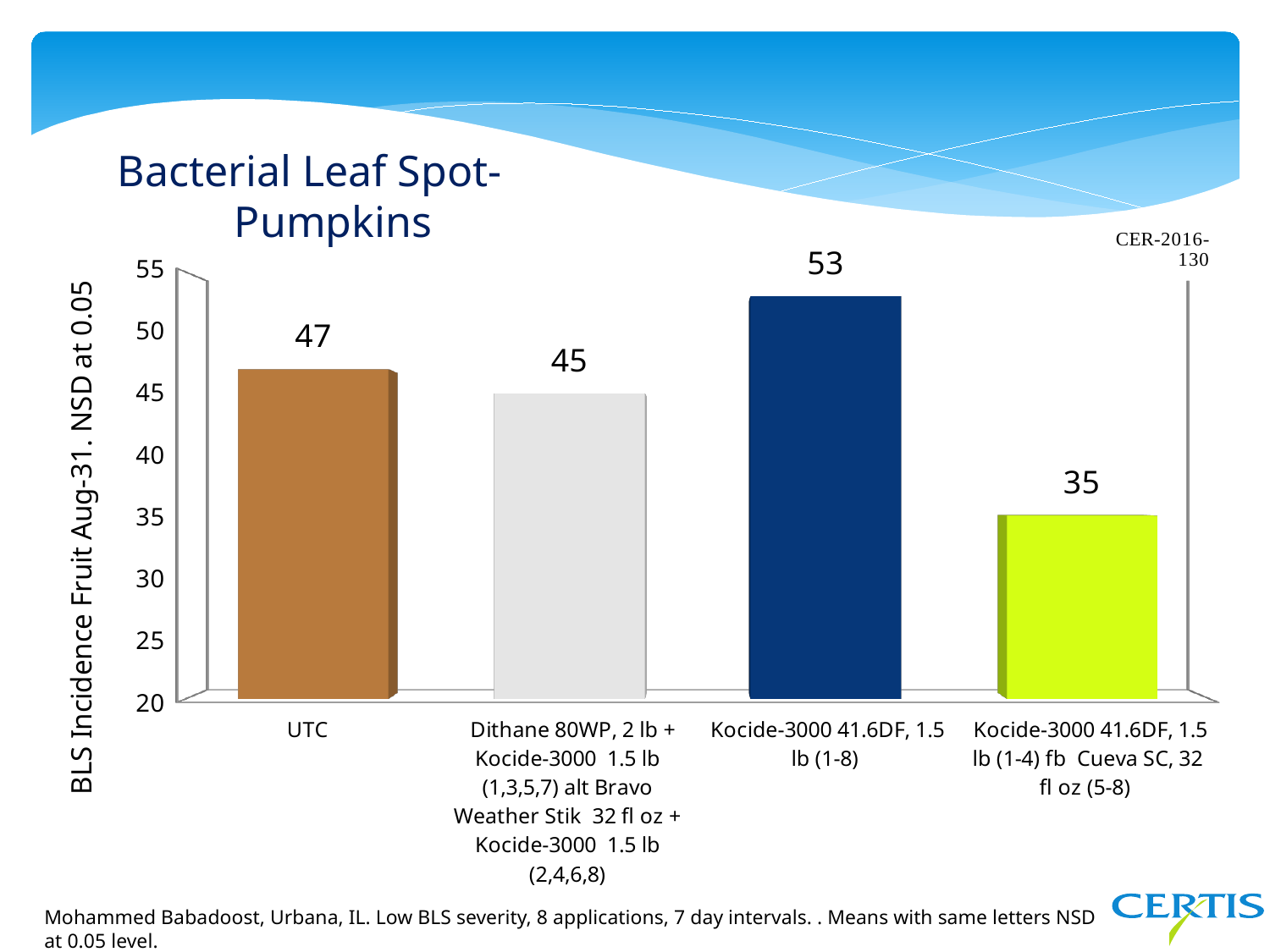
What is the value for the Kocide-3000 41.6DF, 1.5 lb (1-4) fb Cueva SC, 32 fl oz (5-8) treatment? 35 What is the label on the vertical axis of the chart? BLS Incidence Fruit Aug-31. NSD at 0.05 Which is larger, the value for UTC or the value for Kocide-3000 41.6DF, 1.5 lb (1-8)? Kocide-3000 41.6DF, 1.5 lb (1-8) Which treatment has the lowest BLS incidence? Kocide-3000 41.6DF, 1.5 lb (1-4) fb Cueva SC, 32 fl oz (5-8) What is the title of the slide? Bacterial Leaf Spot- Pumpkins What kind of chart is shown on the slide? Bar chart What is the difference between the UTC value and the Kocide-3000 41.6DF, 1.5 lb (1-4) fb Cueva SC value? 12 How many treatments are shown on the chart? 4 What is the value for the Kocide-3000 41.6DF, 1.5 lb (1-8) treatment? 53 What is the value for the Dithane 80WP, 2 lb + Kocide-3000 1.5 lb (1,3,5,7) alt Bravo Weather Stik 32 fl oz + Kocide-3000 1.5 lb (2,4,6,8) treatment? 45 Which treatment has the highest BLS incidence? Kocide-3000 41.6DF, 1.5 lb (1-8) What is the BLS incidence value for UTC? 47